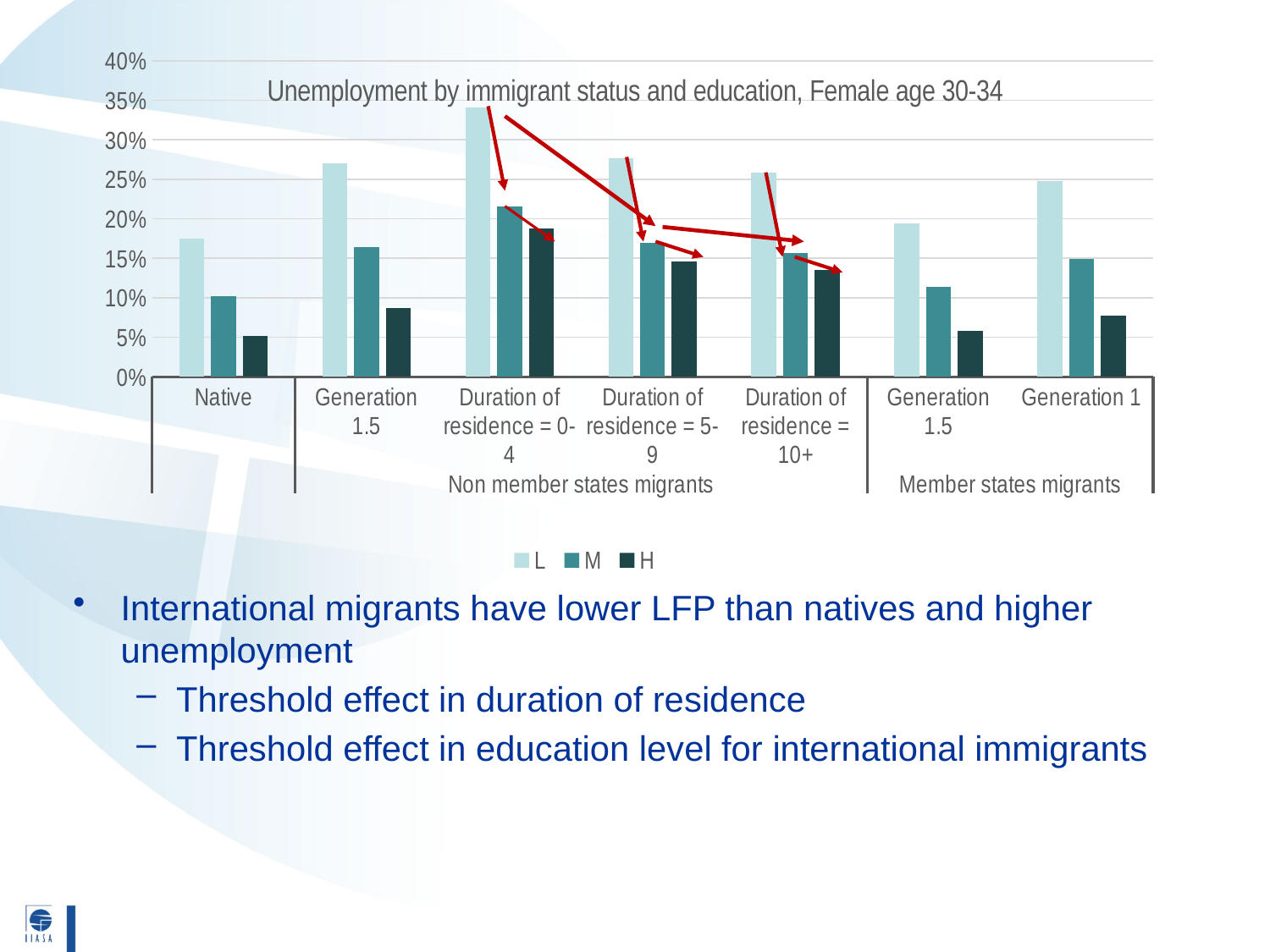
Which category has the highest L bar? Duration of residence = 0-4 Is the H value for Native greater or less than 10%? less Is the L value for Duration of residence = 0-4 greater or less than 30%? greater Is the L value for Generation 1 (Member states migrants) greater or less than 20%? greater Which is larger: the L value for Native or the L value for Generation 1.5 among Non member states migrants? Generation 1.5 (Non member states migrants) What is the title of the chart? Unemployment by immigrant status and education, Female age 30-34 Which is larger: the M value for Duration of residence = 0-4 or the M value for Duration of residence = 10+? Duration of residence = 0-4 What kind of chart is shown on the slide? bar chart Which category has the highest H bar? Duration of residence = 0-4 How many categories are shown along the x axis? 7 How many series does the legend list? 3 Do the L values rise or fall across the three Duration of residence categories from 0-4 to 10+? fall